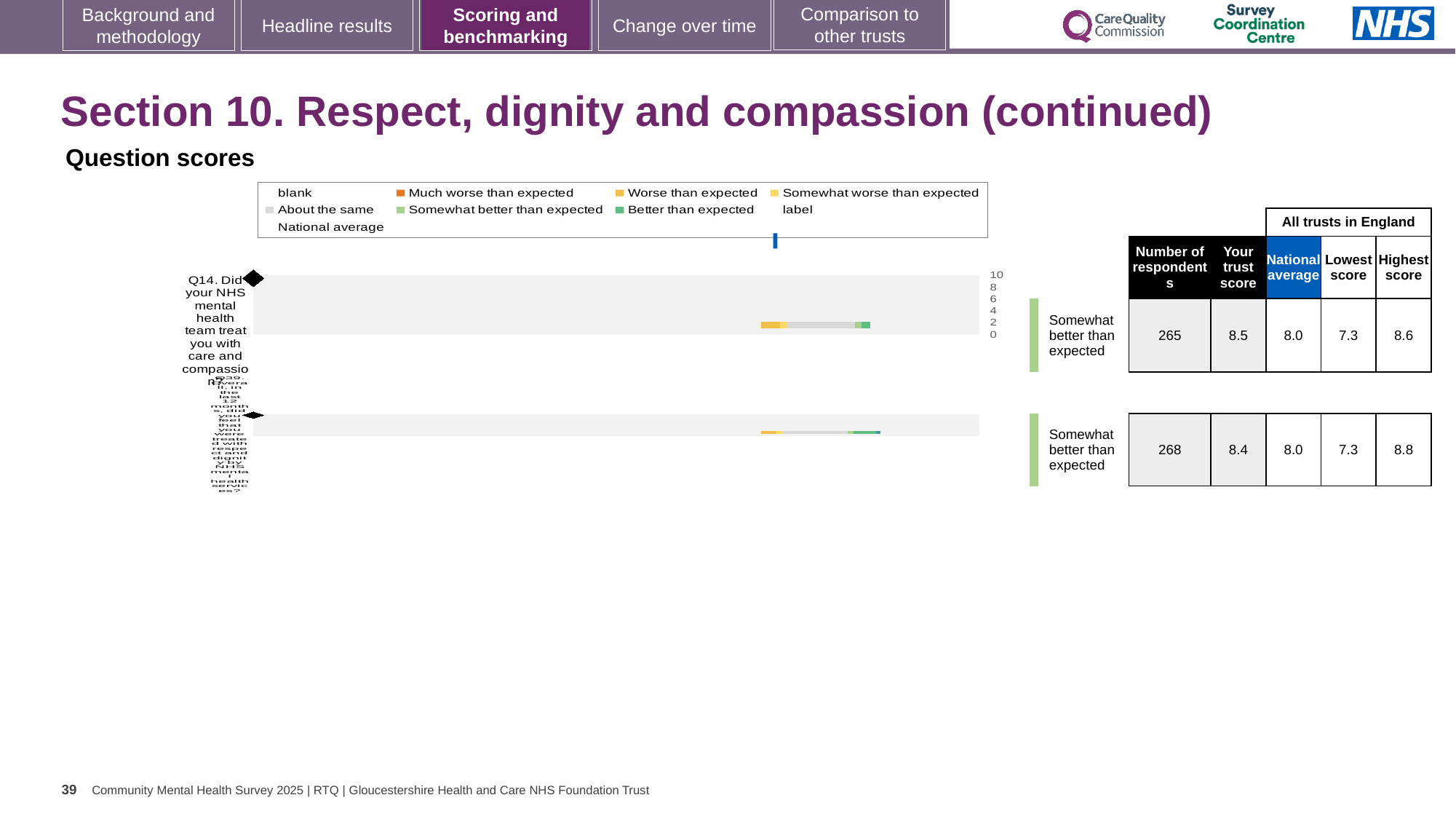
What is the highest score among all trusts in England for Q39? 8.8 Which question has the higher trust score, Q14 or Q39? Q14 How many questions are plotted in the question scores chart? 2 What is the trust score for Q14 (Did your NHS mental health team treat you with care and compassion?)? 8.5 What is the trust score for Q39 (treated with respect and dignity by NHS mental health services)? 8.4 What is the difference between the trust score and the national average for Q14? 0.5 How many respondents answered Q39? 268 What is the lowest score among all trusts in England for Q14? 7.3 How many entries does the legend of the question scores chart list? 9 What kind of chart is used to show the question scores on this slide? bar chart What benchmark category is shown for Q14? Somewhat better than expected What is the national average score for Q14? 8.0